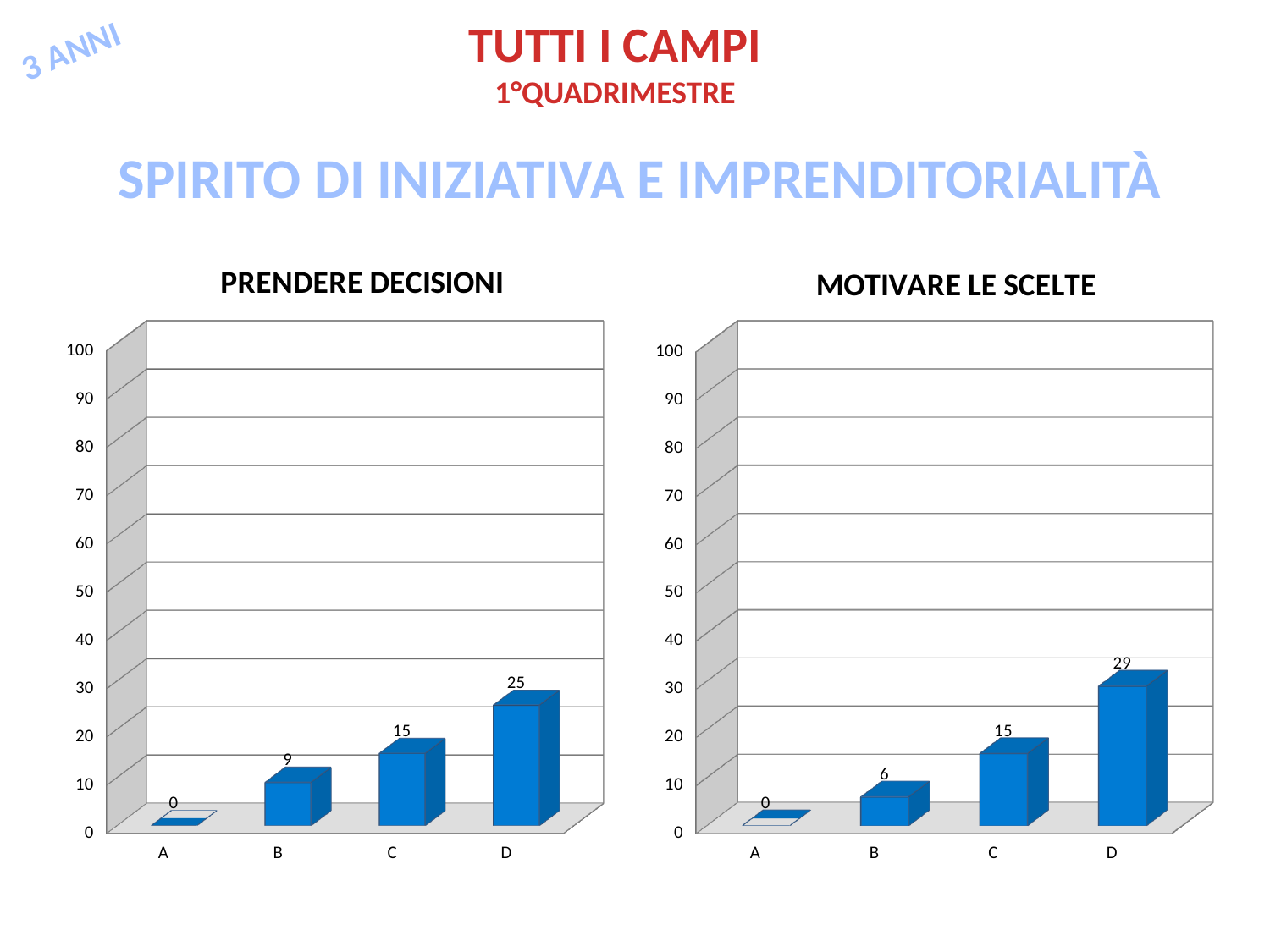
How many categories are shown in the PRENDERE DECISIONI chart? 4 In the MOTIVARE LE SCELTE chart, what is the difference between the values for D and B? 23 Which is larger: the value for D in the PRENDERE DECISIONI chart or the value for D in the MOTIVARE LE SCELTE chart? D in MOTIVARE LE SCELTE In the PRENDERE DECISIONI chart, which category has the highest value? D What kind of chart is the MOTIVARE LE SCELTE chart? bar chart In the MOTIVARE LE SCELTE chart, what is the value for category B? 6 In the MOTIVARE LE SCELTE chart, which category has the lowest value? A In the PRENDERE DECISIONI chart, what is the value for category D? 25 What is the title of the chart on the right side of the slide? MOTIVARE LE SCELTE In the PRENDERE DECISIONI chart, what is the difference between the values for D and C? 10 In the MOTIVARE LE SCELTE chart, is the value for D greater or less than 20? greater In the PRENDERE DECISIONI chart, do the values rise or fall from A to D? rise